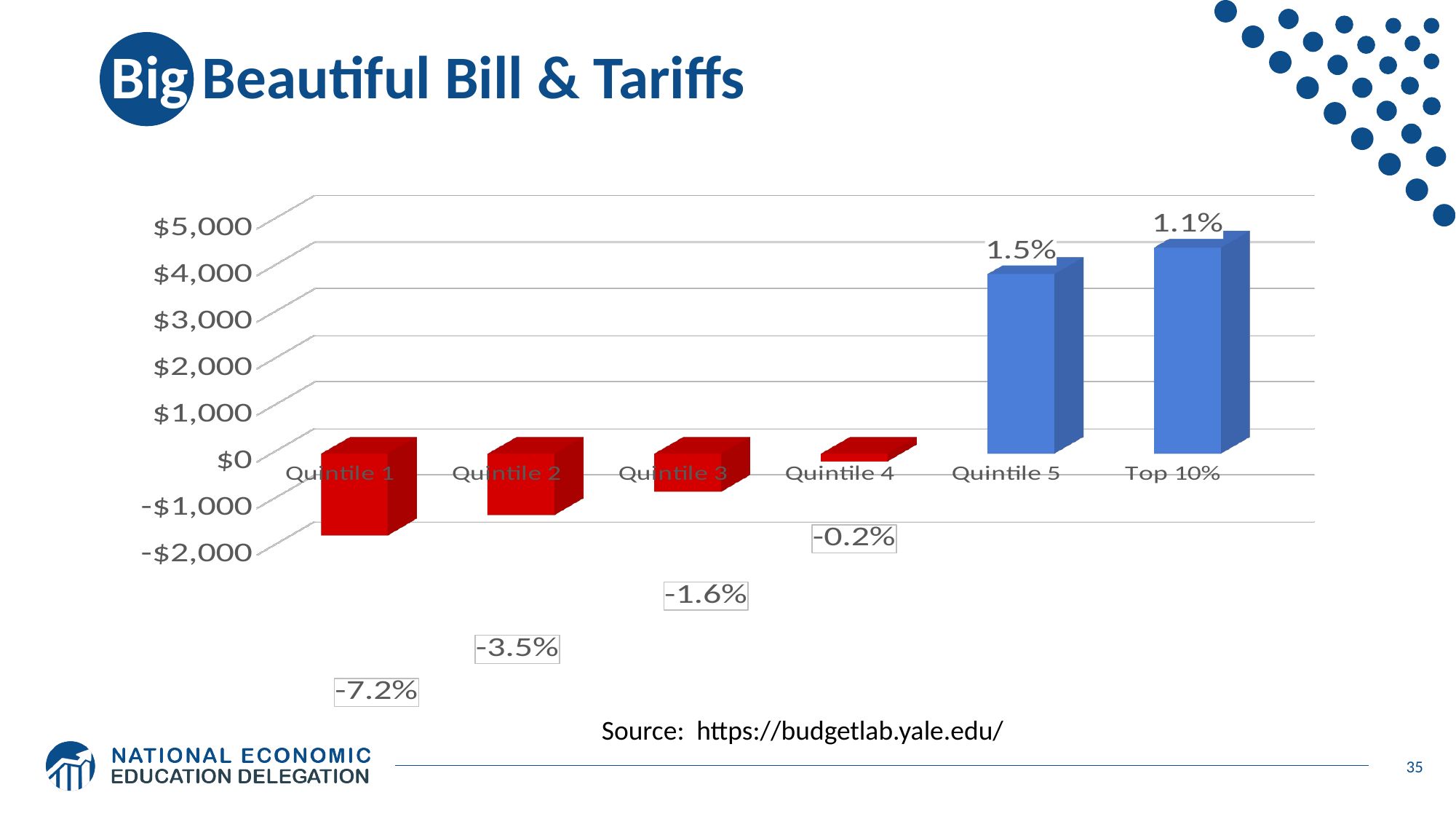
Is the value for Top 10% greater or less than $4,000? greater How many categories are shown on the x axis? 6 What percentage label is shown for Quintile 1? -7.2% What percentage label is shown for Quintile 4? -0.2% What percentage label is shown for Top 10%? 1.1% What kind of chart is shown on the slide? Bar chart Which has the larger value, Quintile 5 or Top 10%? Top 10% What colour are the bars with negative values? Red Which category has the highest value? Top 10% Which category has the lowest value? Quintile 1 What is the difference in percentage points between the labels for Quintile 1 (-7.2%) and Quintile 2 (-3.5%)? 3.7 percentage points Is the value for Quintile 1 greater or less than -$1,000? less